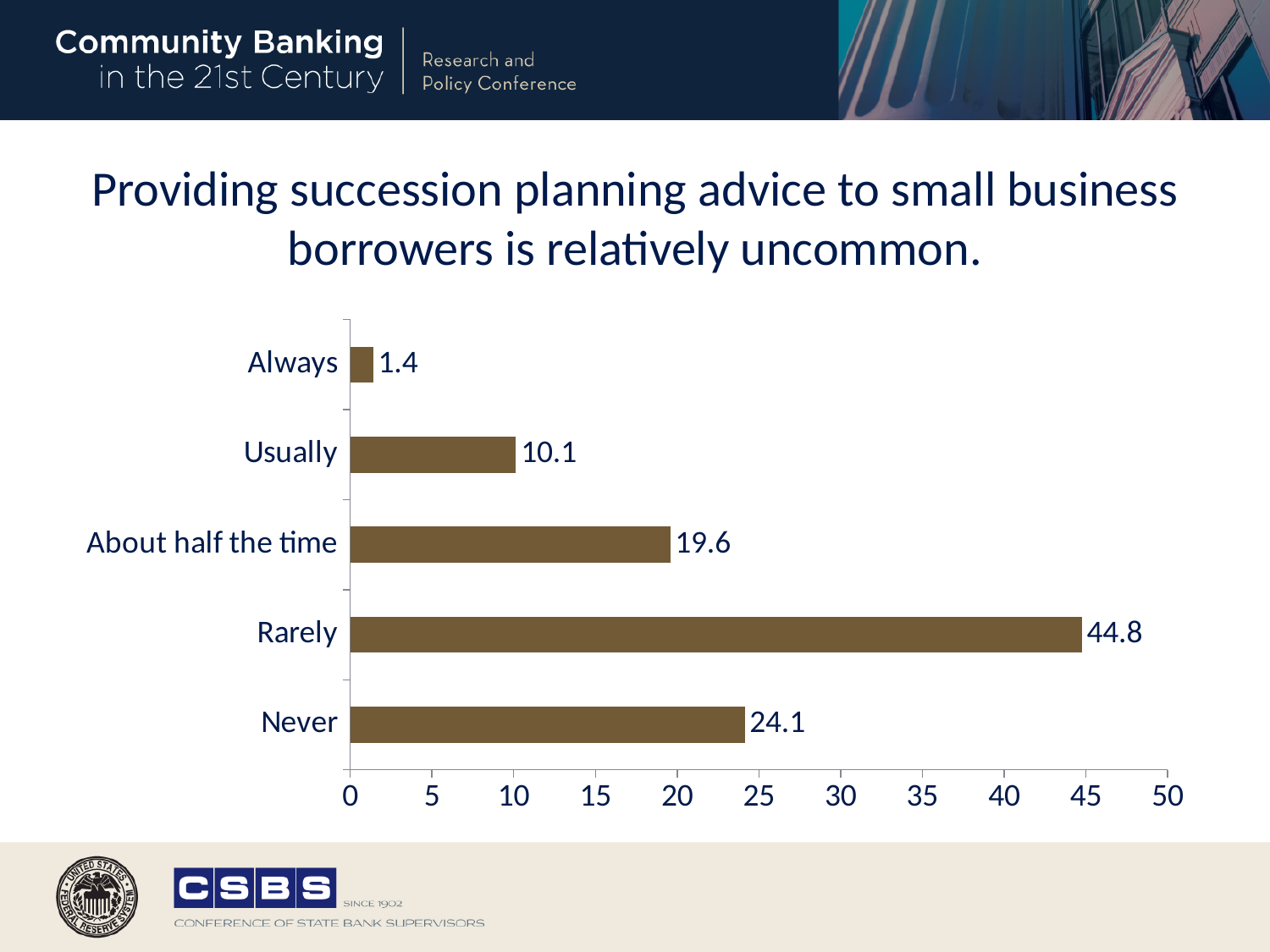
What is the difference between the values for Rarely and Never? 20.7 What is the value for Never? 24.1 What is the difference between the values for About half the time and Usually? 9.5 Which category has the highest value? Rarely Which category has the lowest value? Always Which is larger, the value for Never or the value for About half the time? Never What is the value for Rarely? 44.8 What kind of chart is shown on the slide? Bar chart What is the maximum value shown on the horizontal axis? 50 How many categories are shown in the chart? 5 What is the value for Always? 1.4 What is the value for About half the time? 19.6